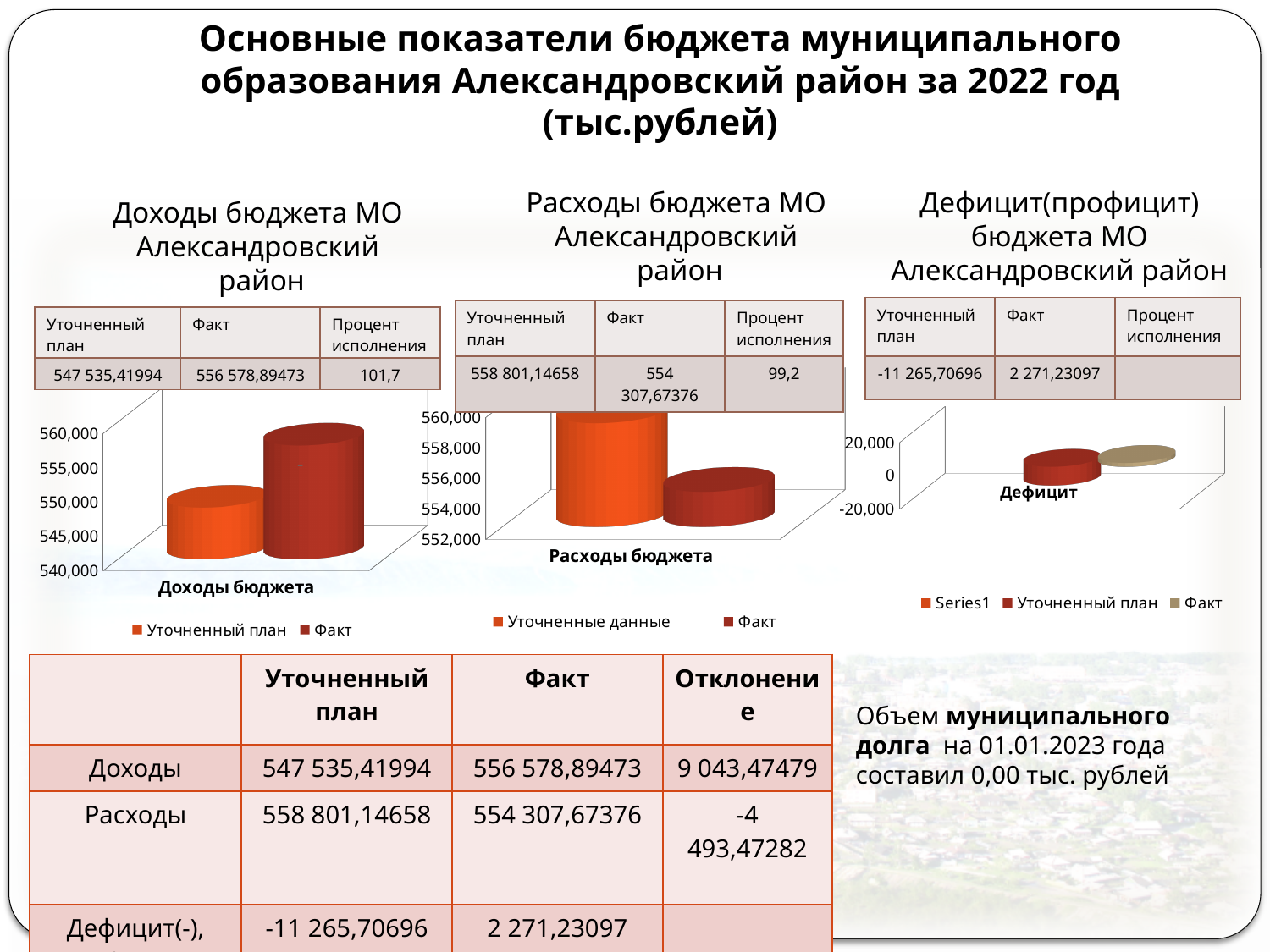
What is the first legend entry of the 'Расходы бюджета МО Александровский район' chart? Уточненные данные In the 'Доходы бюджета МО Александровский район' chart, is the value for Факт greater or less than 550,000? greater In the 'Доходы бюджета МО Александровский район' chart, which is larger: Уточненный план or Факт? Факт What kind of chart is the 'Доходы бюджета МО Александровский район' chart? bar chart How many series does the legend of the 'Дефицит(профицит) бюджета МО Александровский район' chart list? 3 In the 'Доходы бюджета МО Александровский район' chart, what is the Процент исполнения shown in the table above the chart? 101,7 How many series does the legend of the 'Доходы бюджета МО Александровский район' chart list? 2 In the 'Расходы бюджета МО Александровский район' chart, what is the Уточненный план value shown in the table above the chart? 558 801,14658 In the 'Дефицит(профицит) бюджета МО Александровский район' chart, what is the Факт value shown in the table above the chart? 2 271,23097 For Доходы, what is the difference (Отклонение) between Факт and Уточненный план as shown in the bottom table? 9 043,47479 In the 'Расходы бюджета МО Александровский район' chart, which is larger: Уточненный план or Факт? Уточненный план In the 'Расходы бюджета МО Александровский район' chart, is the value for Факт greater or less than 558,000? less